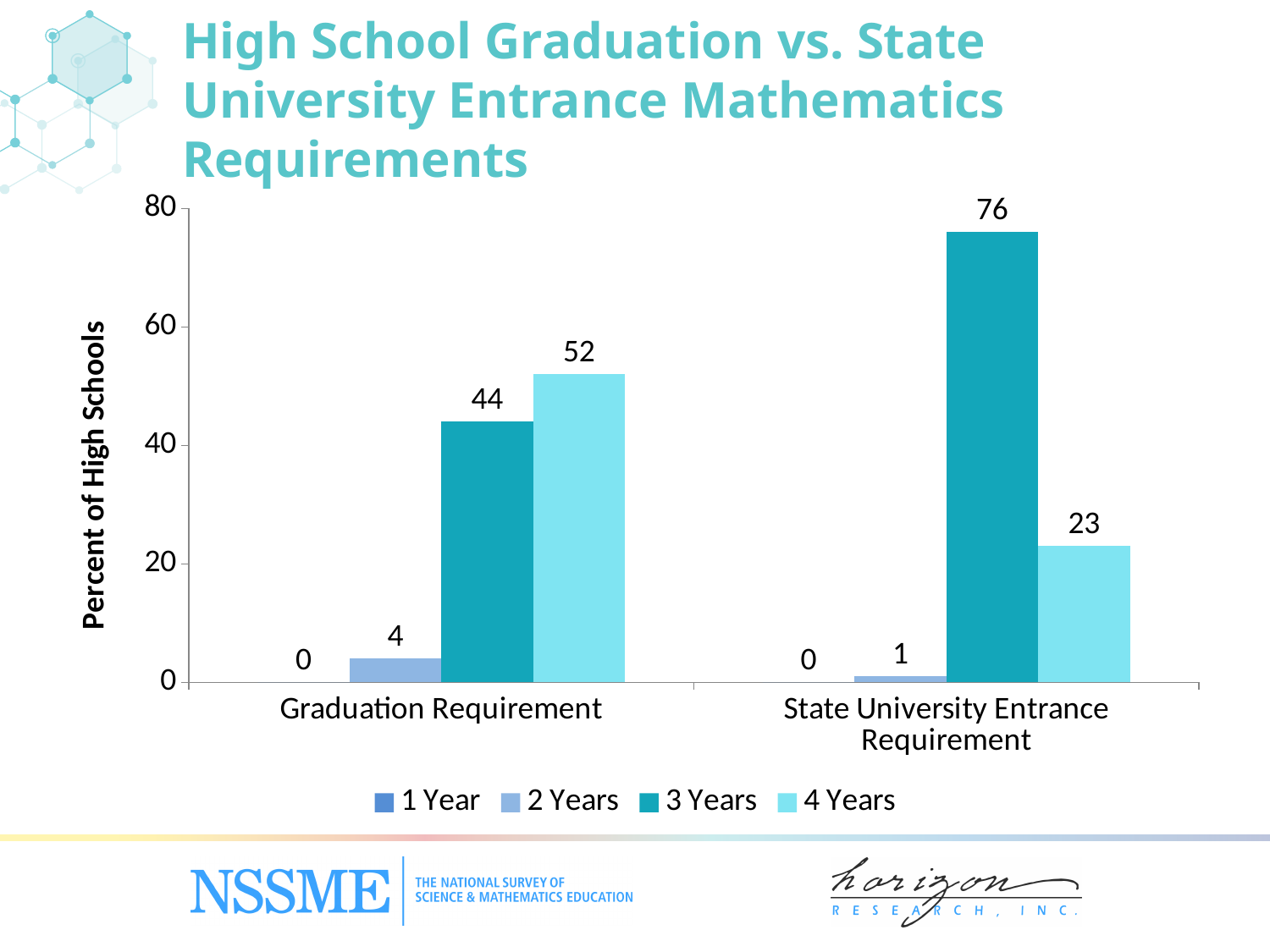
What is the value for 4 Years under State University Entrance Requirement? 23 Which is larger: the 4 Years value for Graduation Requirement or for State University Entrance Requirement? Graduation Requirement Which series has the highest value under State University Entrance Requirement? 3 Years What is the value for 2 Years under Graduation Requirement? 4 What kind of chart is shown on the slide? Bar chart How many series does the legend list? 4 What is the label of the y axis? Percent of High Schools Which series has the highest value under Graduation Requirement? 4 Years What is the value for 1 Year under State University Entrance Requirement? 0 What percent of high schools have a 3 Years mathematics graduation requirement? 44 What is the difference between the 3 Years values for State University Entrance Requirement and Graduation Requirement? 32 How many categories are shown on the x axis? 2